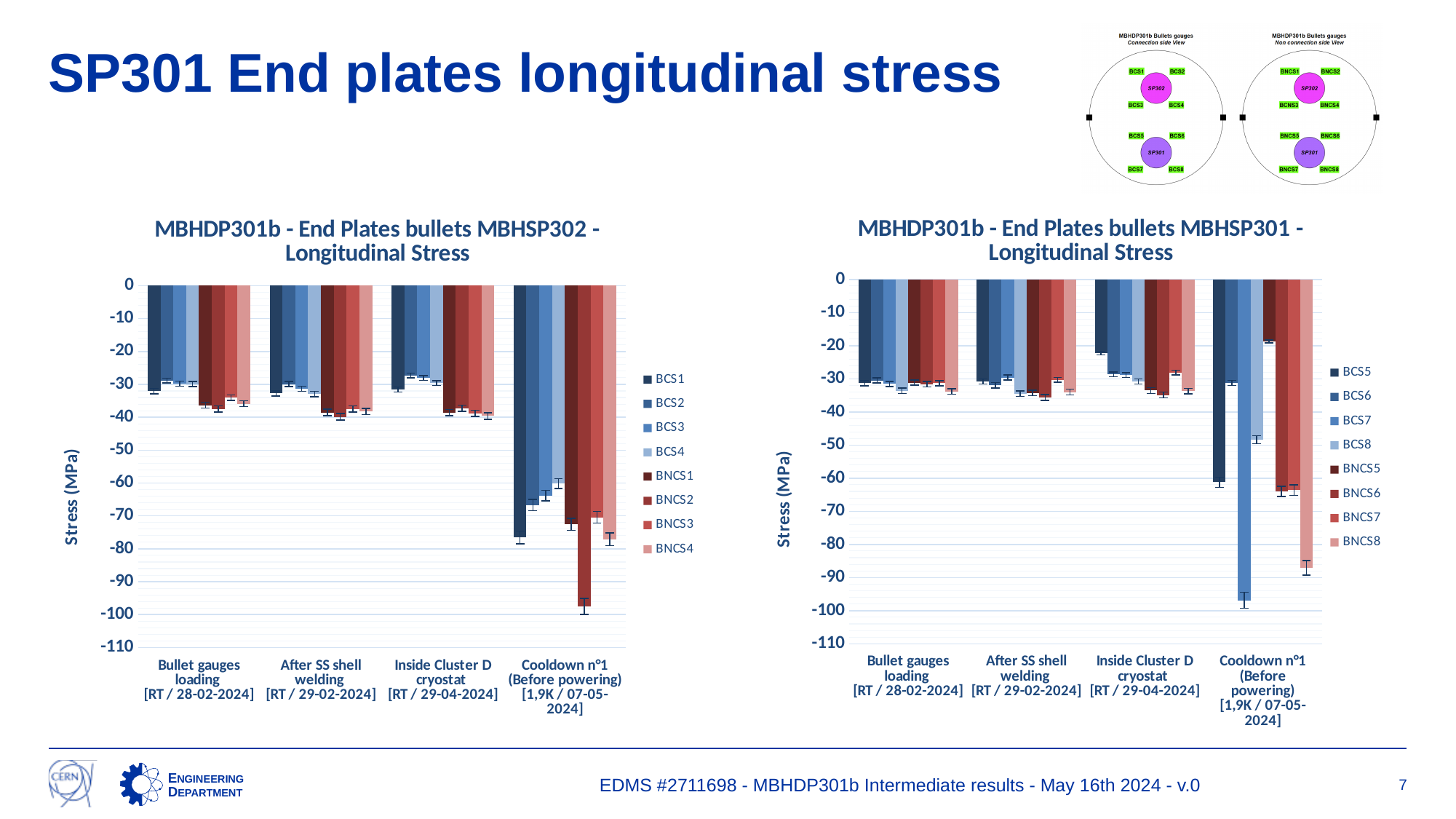
What is the y-axis title of the left chart? Stress (MPa) In the right chart (MBHSP301), at Cooldown n°1, which has the more negative stress: BCS8 or BNCS8? BNCS8 In the left chart (MBHSP302), is the value for BNCS2 at Cooldown n°1 greater or less than -90? less In the left chart (MBHSP302), which series has the most negative stress at Cooldown n°1 (Before powering)? BNCS2 What is the title of the right chart? MBHDP301b - End Plates bullets MBHSP301 - Longitudinal Stress What type of chart is used on this slide for the longitudinal stress data? Bar chart In the left chart (MBHSP302), is the value for BCS4 at Cooldown n°1 greater or less than -70? greater In the right chart (MBHSP301), which series has the most negative stress at Cooldown n°1 (Before powering)? BCS7 In the right chart (MBHSP301), is the value for BCS7 at Cooldown n°1 greater or less than -90? less In the right chart (MBHSP301), how many categories are shown on the x axis? 4 In the left chart (MBHSP302), how many series does the legend list? 8